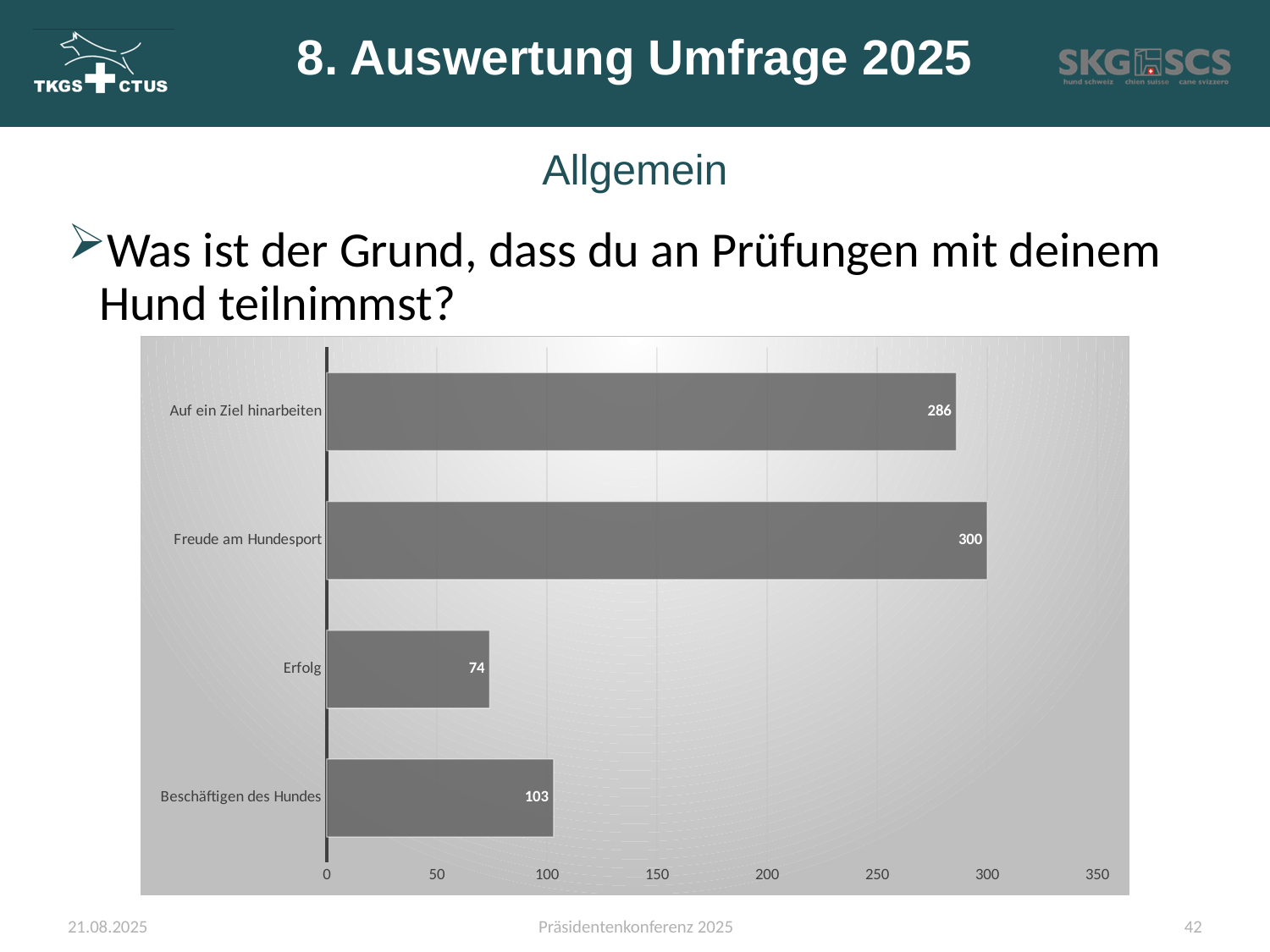
What is the difference between the values for "Beschäftigen des Hundes" and "Erfolg"? 29 Which is larger, the value for "Beschäftigen des Hundes" or the value for "Erfolg"? Beschäftigen des Hundes What kind of chart is shown on the slide? bar chart How many categories are shown in the chart? 4 Which category has the highest value? Freude am Hundesport What is the value for "Auf ein Ziel hinarbeiten"? 286 What is the value for "Beschäftigen des Hundes"? 103 What is the value for "Freude am Hundesport"? 300 Which category has the lowest value? Erfolg Is the value for "Auf ein Ziel hinarbeiten" greater or less than 250? greater What is the value for "Erfolg"? 74 What is the difference between the values for "Freude am Hundesport" and "Auf ein Ziel hinarbeiten"? 14